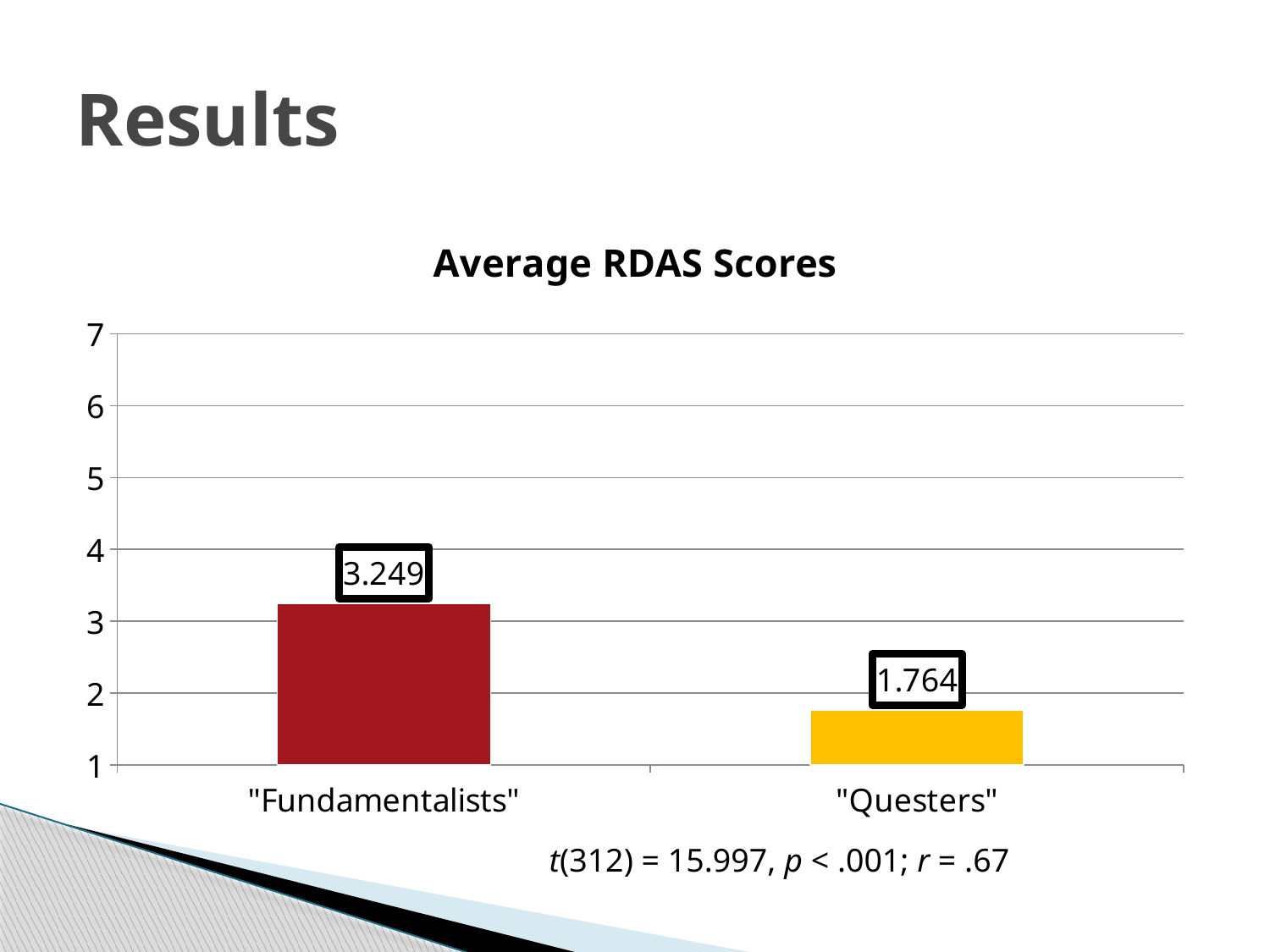
What kind of chart is shown on the slide? Bar chart What is the title of the chart? Average RDAS Scores What is the highest value shown on the vertical axis? 7 How many groups are shown in the chart? 2 Which group has the higher average RDAS score? "Fundamentalists" Is the average RDAS score for "Fundamentalists" greater or less than 3? greater What is the average RDAS score for "Fundamentalists"? 3.249 What is the average RDAS score for "Questers"? 1.764 What colour is the bar for "Questers"? Yellow Which group has the lower average RDAS score? "Questers" Is the average RDAS score for "Questers" greater or less than 2? less What is the difference between the average RDAS scores of "Fundamentalists" and "Questers"? 1.485